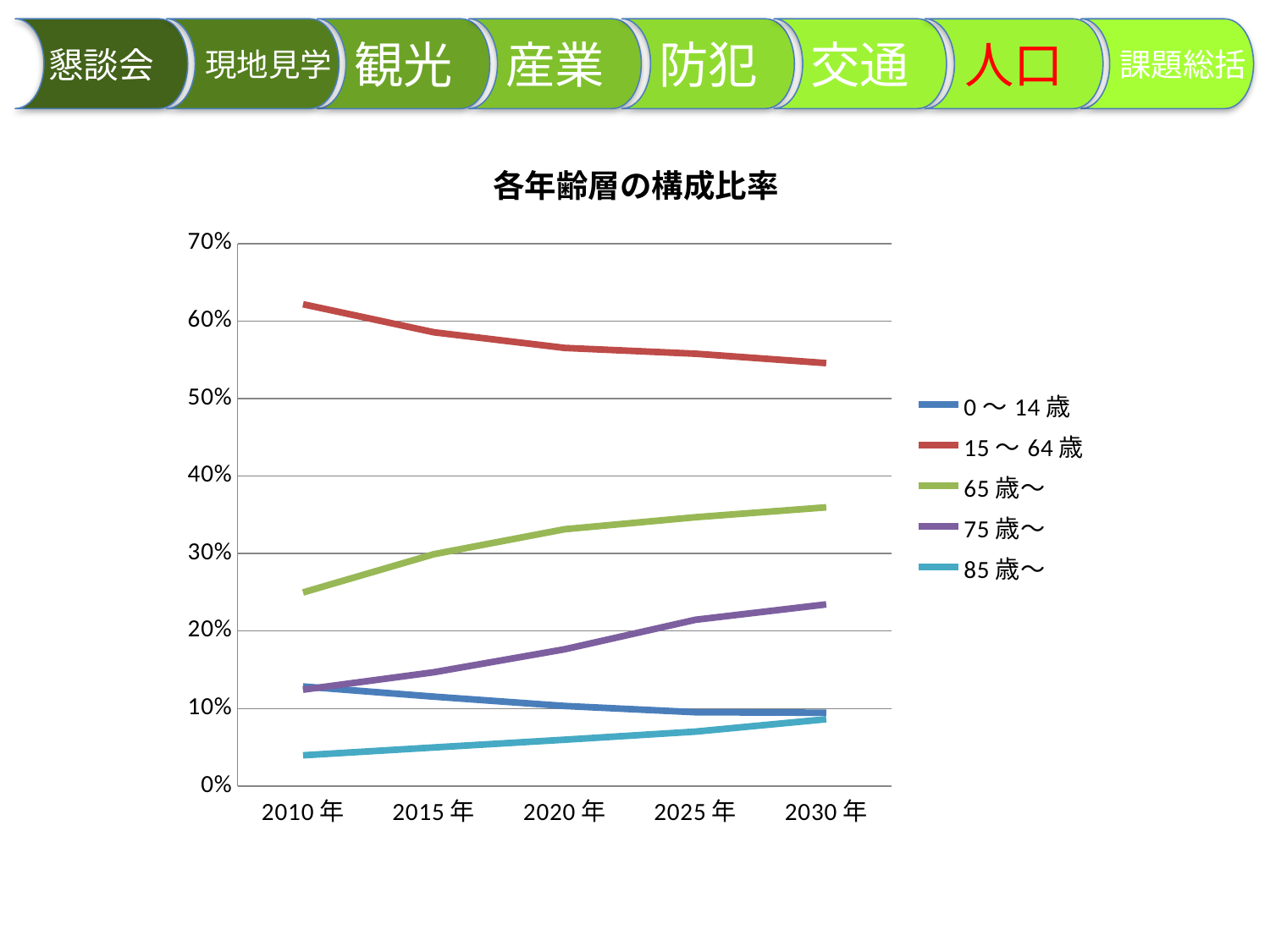
Is the value for 15～64歳 in 2010年 greater or less than 60%? greater Which series has the lowest value in 2010年? 85歳～ Does the value for 0～14歳 rise or fall from 2010年 to 2030年? fall Is the value for 65歳～ in 2010年 greater or less than 30%? less Which series has the highest value in 2030年? 15～64歳 Is the value for 85歳～ in 2010年 greater or less than 10%? less What kind of chart is shown on the slide? line chart Does the value for 65歳～ rise or fall from 2010年 to 2030年? rise What is the title of the chart? 各年齢層の構成比率 How many years are shown along the x axis? 5 Does the value for 15～64歳 rise or fall from 2010年 to 2030年? fall How many series does the legend list? 5